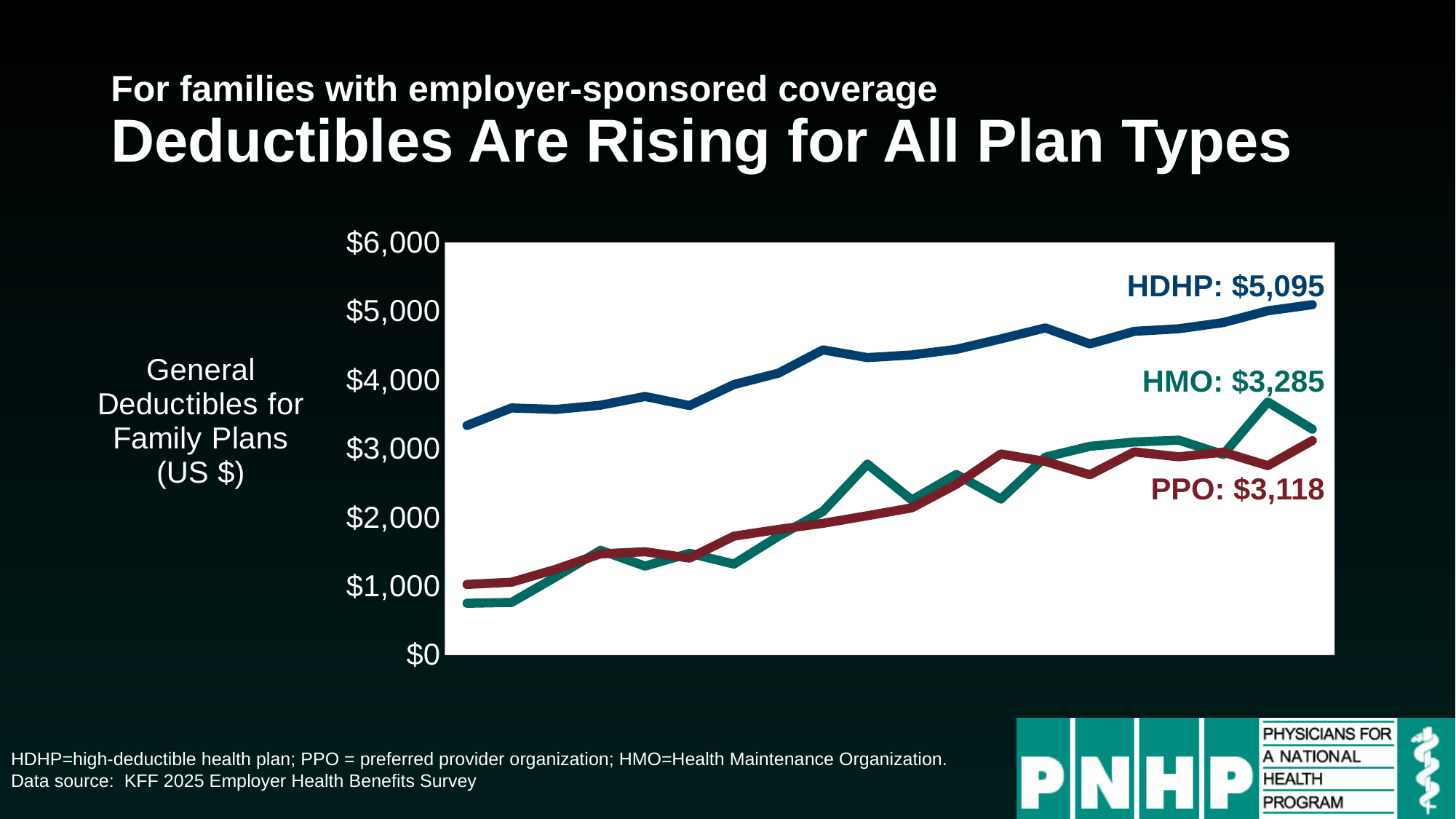
Which plan type has the lowest final deductible value? PPO What is the difference between the final HMO value and the final PPO value? $167 What is the final labeled value for HMO? $3,285 Is the starting value of the HDHP line greater or less than $3,000? greater What is the difference between the final HDHP value and the final HMO value? $1,810 Does the HDHP line generally rise or fall from left to right? rise What is the final labeled value for HDHP? $5,095 Is the final HMO value larger or smaller than the final PPO value? larger Is the starting value of the HMO line greater or less than $1,000? less Which plan type has the highest final deductible value? HDHP What is the final labeled value for PPO? $3,118 What kind of chart is shown on the slide? line chart